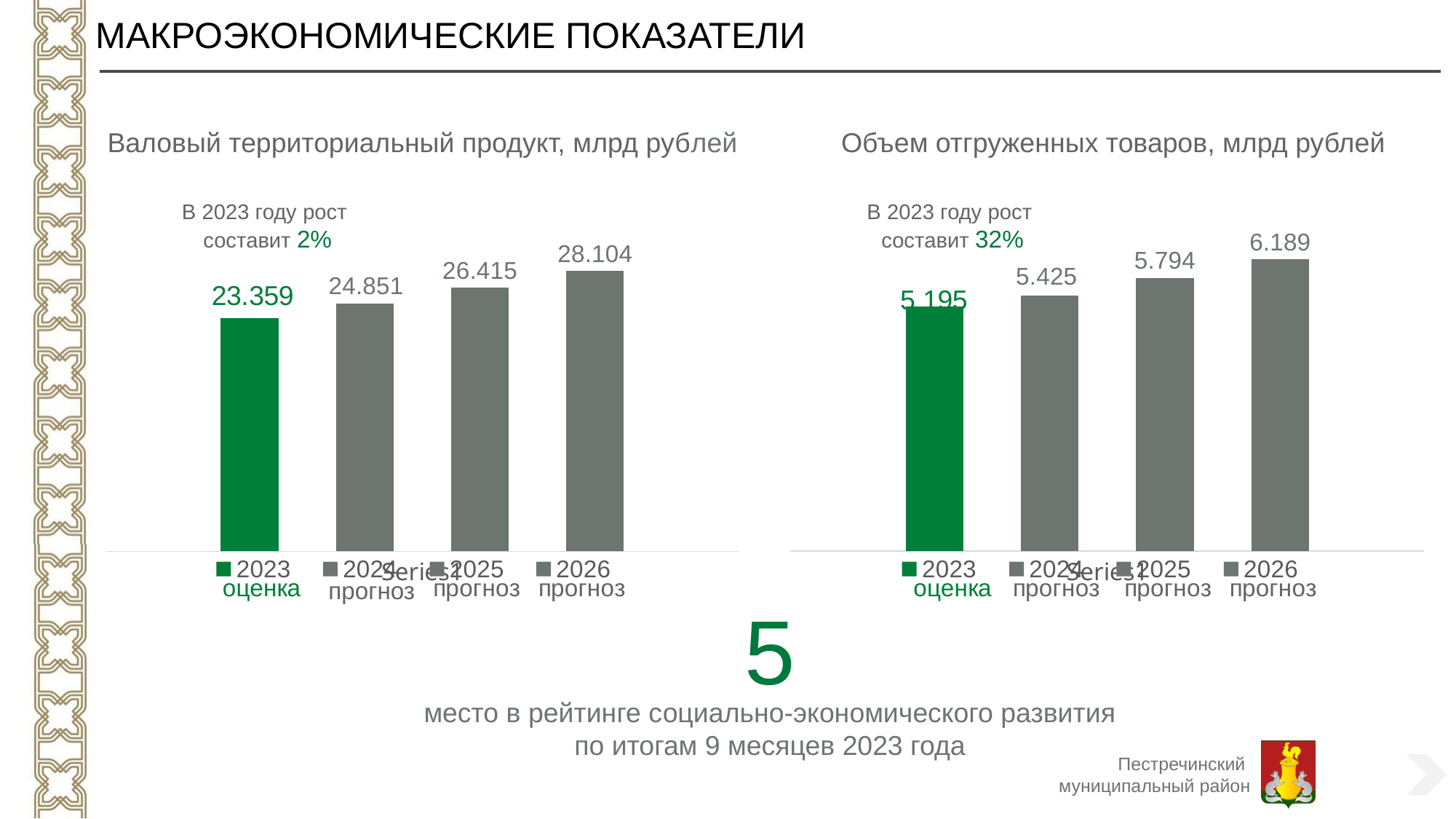
In the chart 'Объем отгруженных товаров, млрд рублей', which category has the lowest value? 2023 оценка In the chart 'Валовый территориальный продукт, млрд рублей', how many bars are plotted? 4 In the chart 'Объем отгруженных товаров, млрд рублей', what is the difference between the 2026 прогноз and 2023 оценка values? 0.994 In the chart 'Валовый территориальный продукт, млрд рублей', which category has the highest value? 2026 прогноз In the chart 'Валовый территориальный продукт, млрд рублей', what is the difference between the 2026 прогноз and 2023 оценка values? 4.745 In the chart 'Валовый территориальный продукт, млрд рублей', what is the value for 2023 оценка? 23.359 What type of chart is used for 'Объем отгруженных товаров, млрд рублей'? bar chart In the chart 'Объем отгруженных товаров, млрд рублей', which is larger: the value for 2024 прогноз or 2025 прогноз? 2025 прогноз In the chart 'Валовый территориальный продукт, млрд рублей', do the values rise or fall from 2023 to 2026? rise In the chart 'Объем отгруженных товаров, млрд рублей', what is the value for 2025 прогноз? 5.794 In the chart 'Объем отгруженных товаров, млрд рублей', what is the value for 2023 оценка? 5.195 In the chart 'Валовый территориальный продукт, млрд рублей', what is the value for 2026 прогноз? 28.104